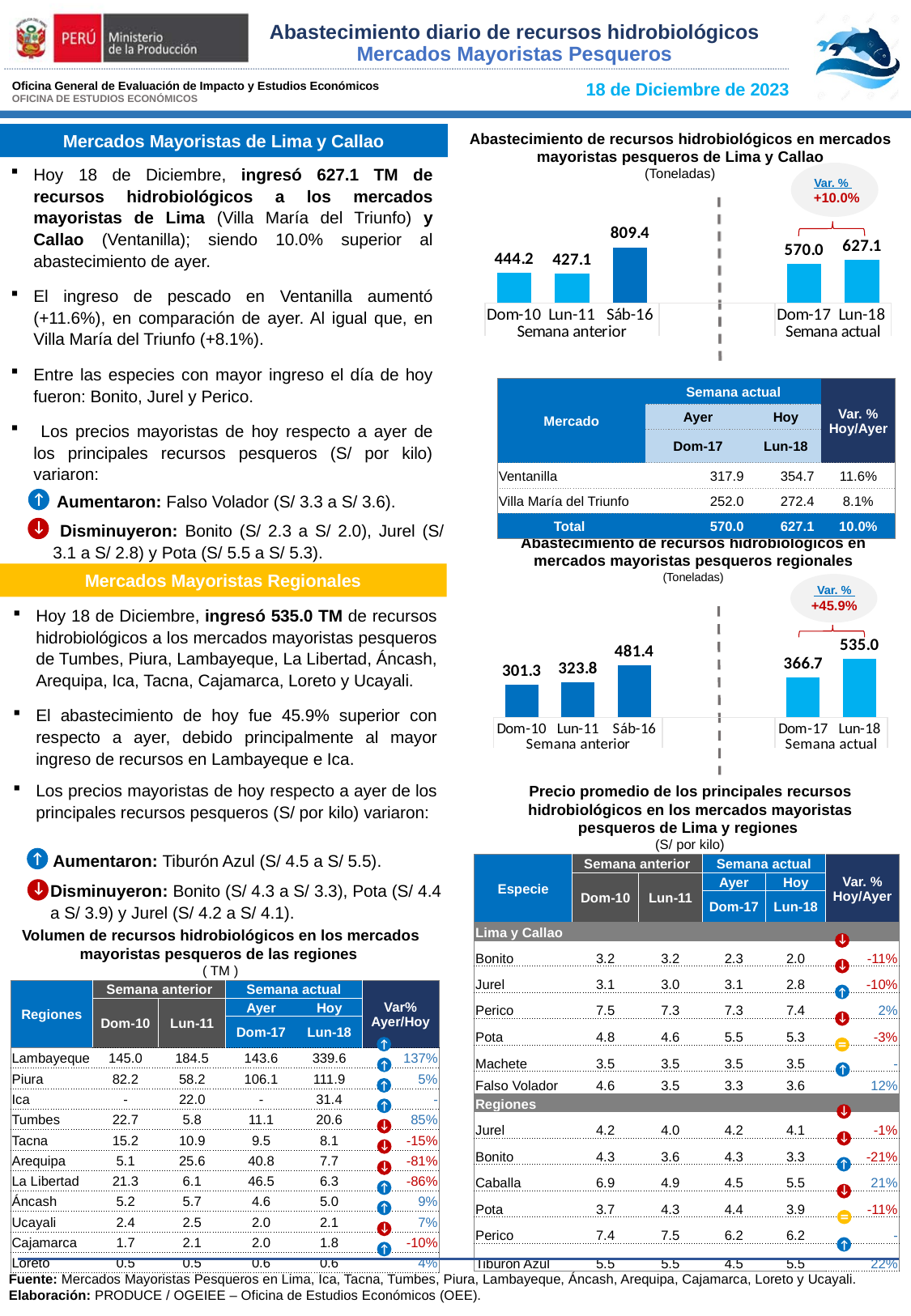
In the chart 'Abastecimiento de recursos hidrobiológicos en mercados mayoristas pesqueros de Lima y Callao', which day has the highest value? Sáb-16 In the chart 'Abastecimiento de recursos hidrobiológicos en mercados mayoristas pesqueros regionales', what is the difference between Lun-18 and Dom-17? 168.3 What type of chart is 'Abastecimiento de recursos hidrobiológicos en mercados mayoristas pesqueros de Lima y Callao'? Bar chart In the chart 'Abastecimiento de recursos hidrobiológicos en mercados mayoristas pesqueros regionales', what is the value for Sáb-16? 481.4 In the chart 'Abastecimiento de recursos hidrobiológicos en mercados mayoristas pesqueros de Lima y Callao', what is the value for Lun-18? 627.1 In the chart 'Abastecimiento de recursos hidrobiológicos en mercados mayoristas pesqueros regionales', which is larger, Dom-17 or Lun-18? Lun-18 In the chart 'Abastecimiento de recursos hidrobiológicos en mercados mayoristas pesqueros regionales', which day has the lowest value? Dom-10 In the chart 'Abastecimiento de recursos hidrobiológicos en mercados mayoristas pesqueros regionales', what is the value for Lun-18? 535.0 In the chart 'Abastecimiento de recursos hidrobiológicos en mercados mayoristas pesqueros de Lima y Callao', which day has the lowest value? Lun-11 In the chart 'Abastecimiento de recursos hidrobiológicos en mercados mayoristas pesqueros de Lima y Callao', what is the difference between Lun-18 and Dom-17? 57.1 In the chart 'Abastecimiento de recursos hidrobiológicos en mercados mayoristas pesqueros de Lima y Callao', how many bars are plotted? 5 In the chart 'Abastecimiento de recursos hidrobiológicos en mercados mayoristas pesqueros de Lima y Callao', what is the value for Dom-10? 444.2